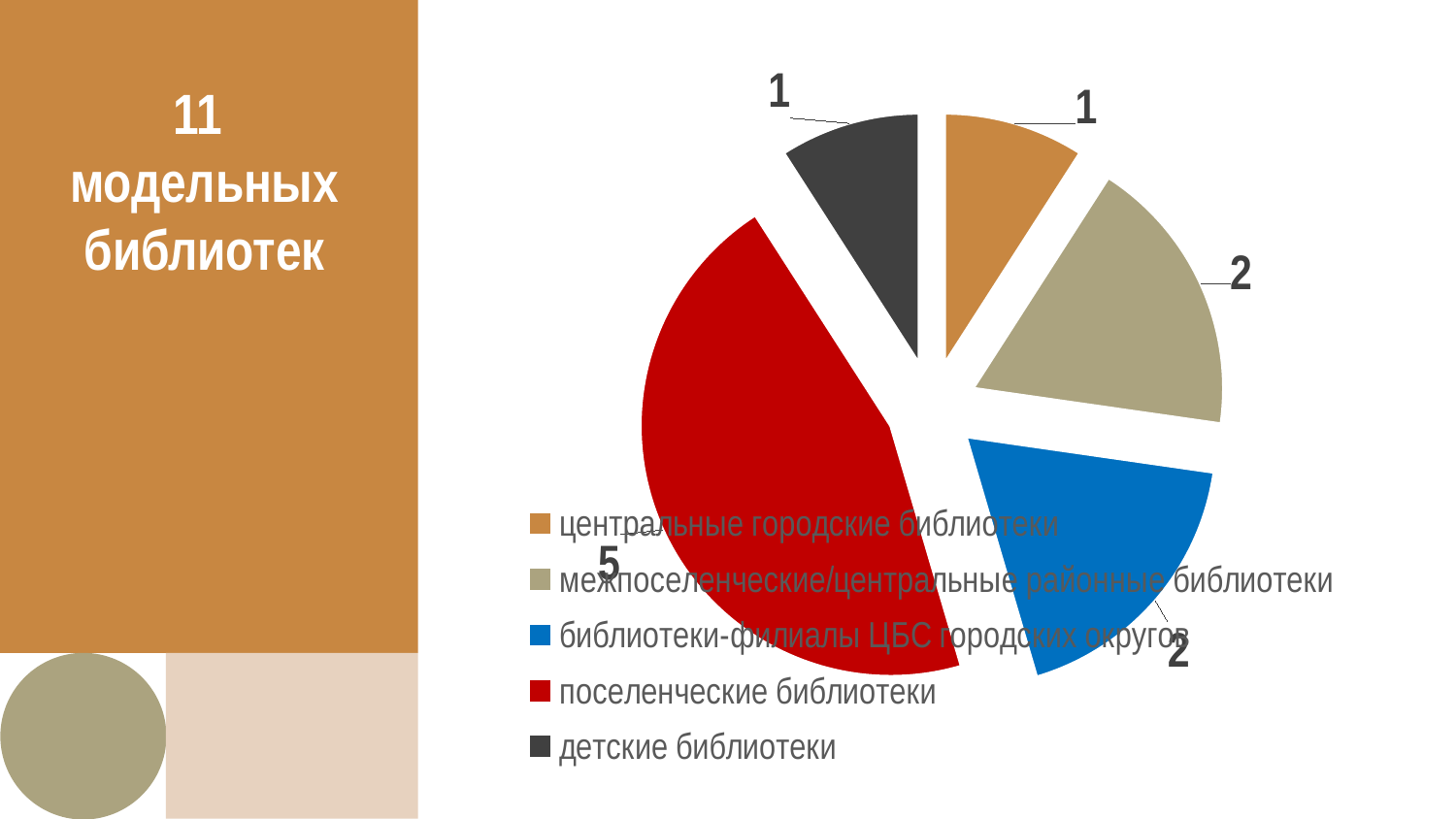
What kind of chart is shown on the slide? pie chart What is the difference between the values for поселенческие библиотеки and межпоселенческие/центральные районные библиотеки? 3 How many entries does the legend of the pie chart list? 5 Which category has the largest slice in the pie chart? поселенческие библиотеки What colour is the slice for поселенческие библиотеки? red What is the value for поселенческие библиотеки in the pie chart? 5 What is the total of all slice values in the pie chart? 11 What is the value for детские библиотеки in the pie chart? 1 What is the value for центральные городские библиотеки in the pie chart? 1 How many slices does the pie chart have? 5 What is the value for библиотеки-филиалы ЦБС городских округов in the pie chart? 2 Which is larger: the value for поселенческие библиотеки or the value for библиотеки-филиалы ЦБС городских округов? поселенческие библиотеки